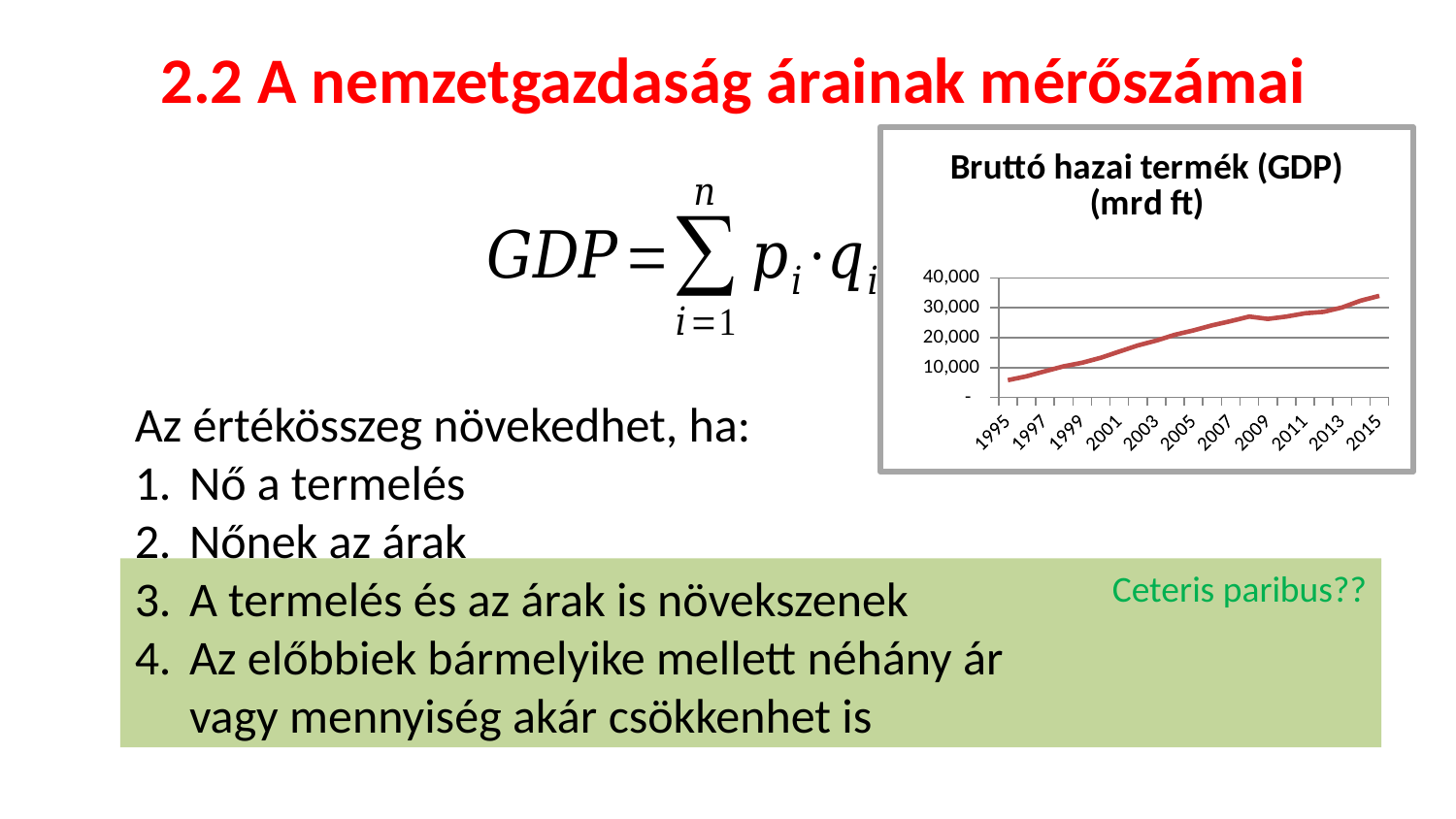
What is the title of the chart on the slide? Bruttó hazai termék (GDP) (mrd ft) What is the highest value labeled on the y axis of the chart? 40,000 Is the GDP value for 2015 greater or less than 30,000? greater Is the GDP value for 2009 greater or less than 30,000? less Is the GDP value for 1995 greater or less than 10,000? less What kind of chart is shown on the slide? line chart How many year labels are shown on the x axis of the chart? 11 Do the GDP values rise or fall from 1995 to 2015 in the chart? rise Which year has a larger GDP value, 2003 or 2013? 2013 Which year has the highest GDP value in the chart? 2015 Which year has the lowest GDP value in the chart? 1995